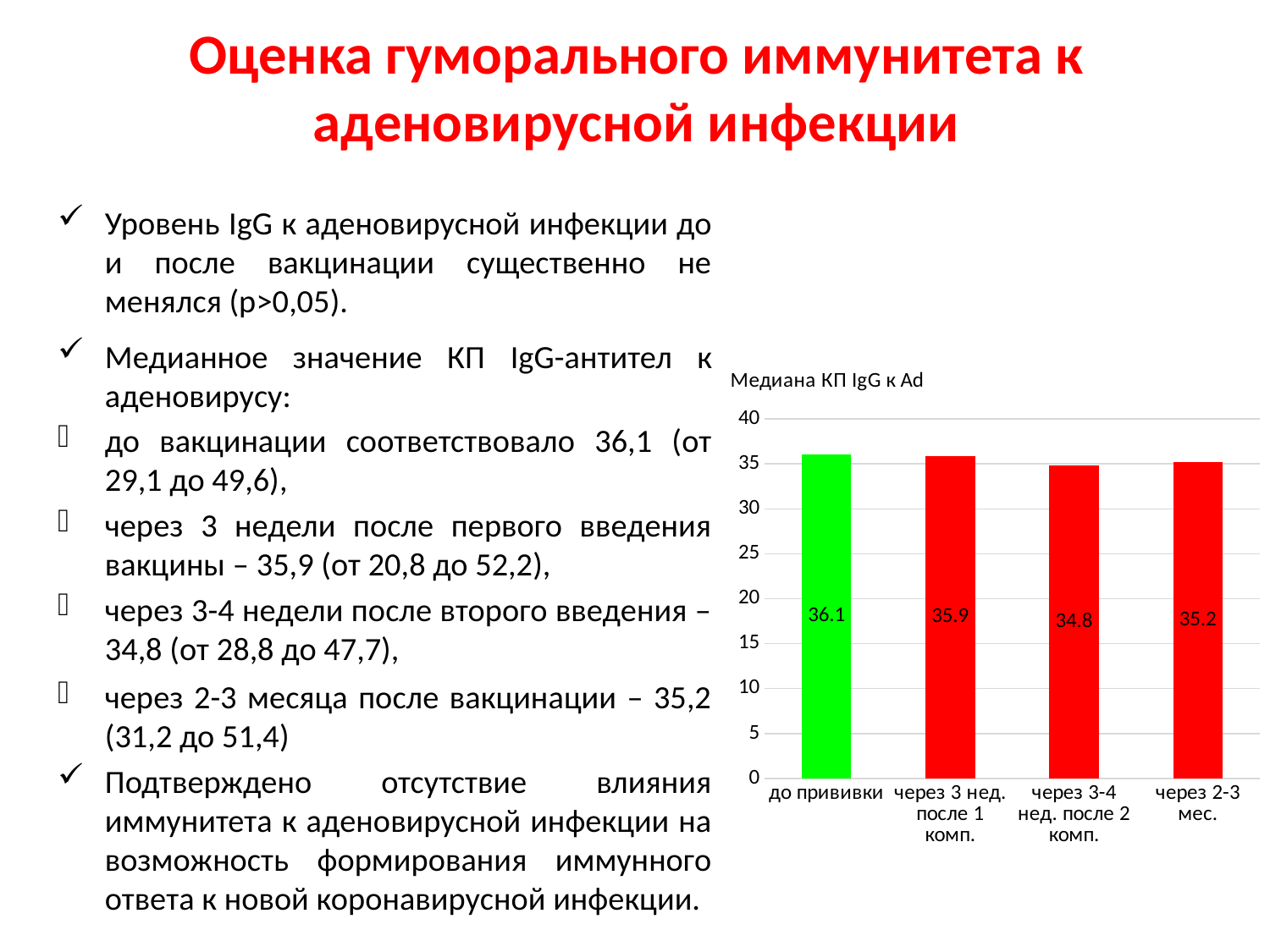
Which category has the lowest value in the chart? через 3-4 нед. после 2 комп. Which category has the highest value in the chart? до прививки What is the value for "через 2-3 мес." in the chart? 35.2 Is the value for "через 2-3 мес." greater or less than 30? greater What is the value for "до прививки" in the chart? 36.1 Which is larger: the value for "через 3 нед. после 1 комп." or the value for "через 2-3 мес."? через 3 нед. после 1 комп. How many categories are shown in the chart? 4 What is the difference between the values for "до прививки" and "через 3-4 нед. после 2 комп."? 1.3 What is the value for "через 3 нед. после 1 комп." in the chart? 35.9 What is the value for "через 3-4 нед. после 2 комп." in the chart? 34.8 What kind of chart is shown on the slide? bar chart What is the title of the chart? Медиана КП IgG к Ad